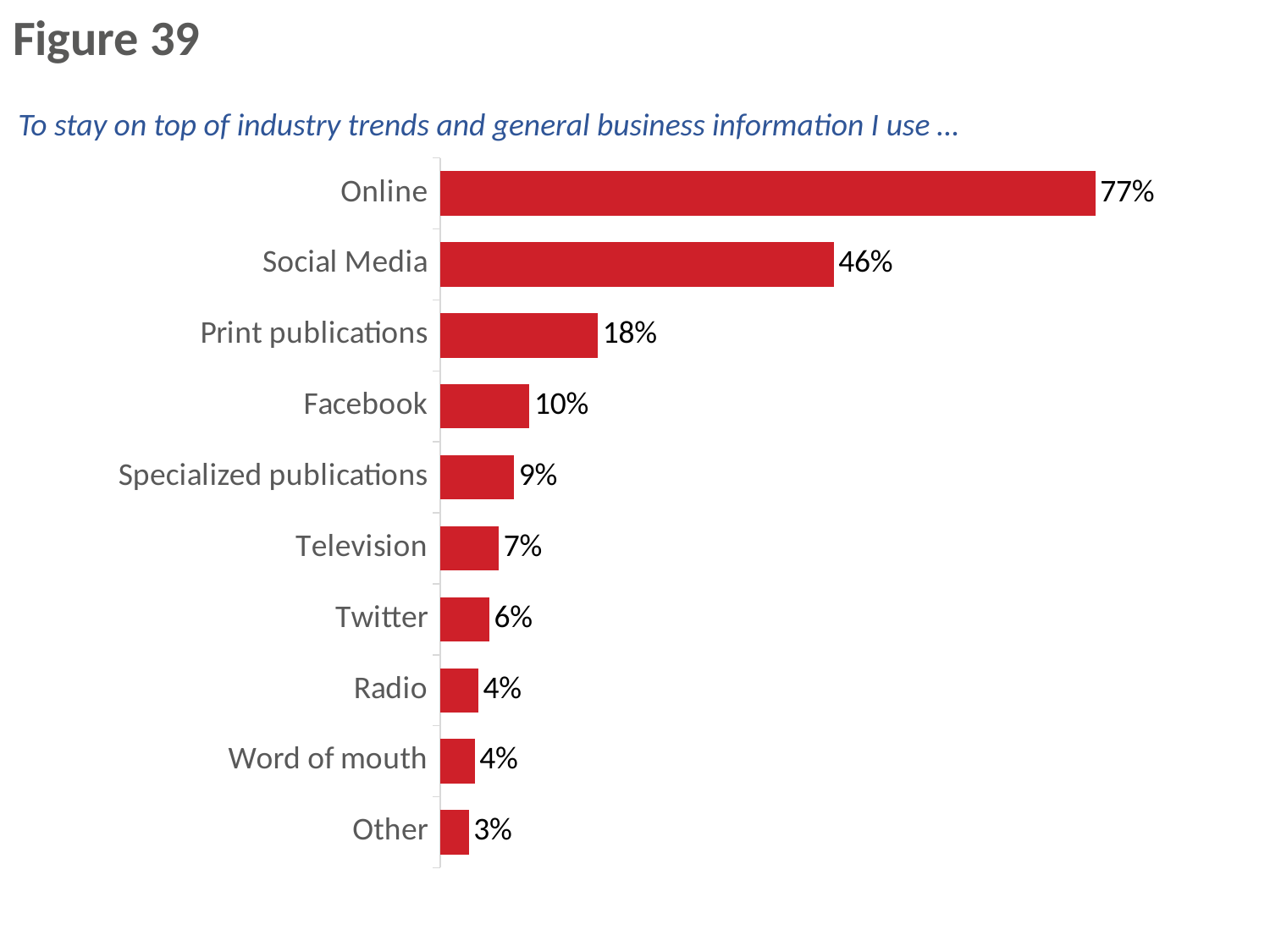
Which is larger, the value for Television or the value for Twitter? Television What percentage of respondents use Online to stay on top of industry trends? 77% What is the value for Social Media? 46% Which category has the lowest value? Other Which category has the highest value? Online How many categories are shown in the chart? 10 What colour are the bars in the chart? Red What is the value for Specialized publications? 9% What is the difference between the values for Online and Social Media? 31% What is the title of the chart? To stay on top of industry trends and general business information I use … What is the difference between the values for Print publications and Facebook? 8% What kind of chart is shown on the slide? Bar chart